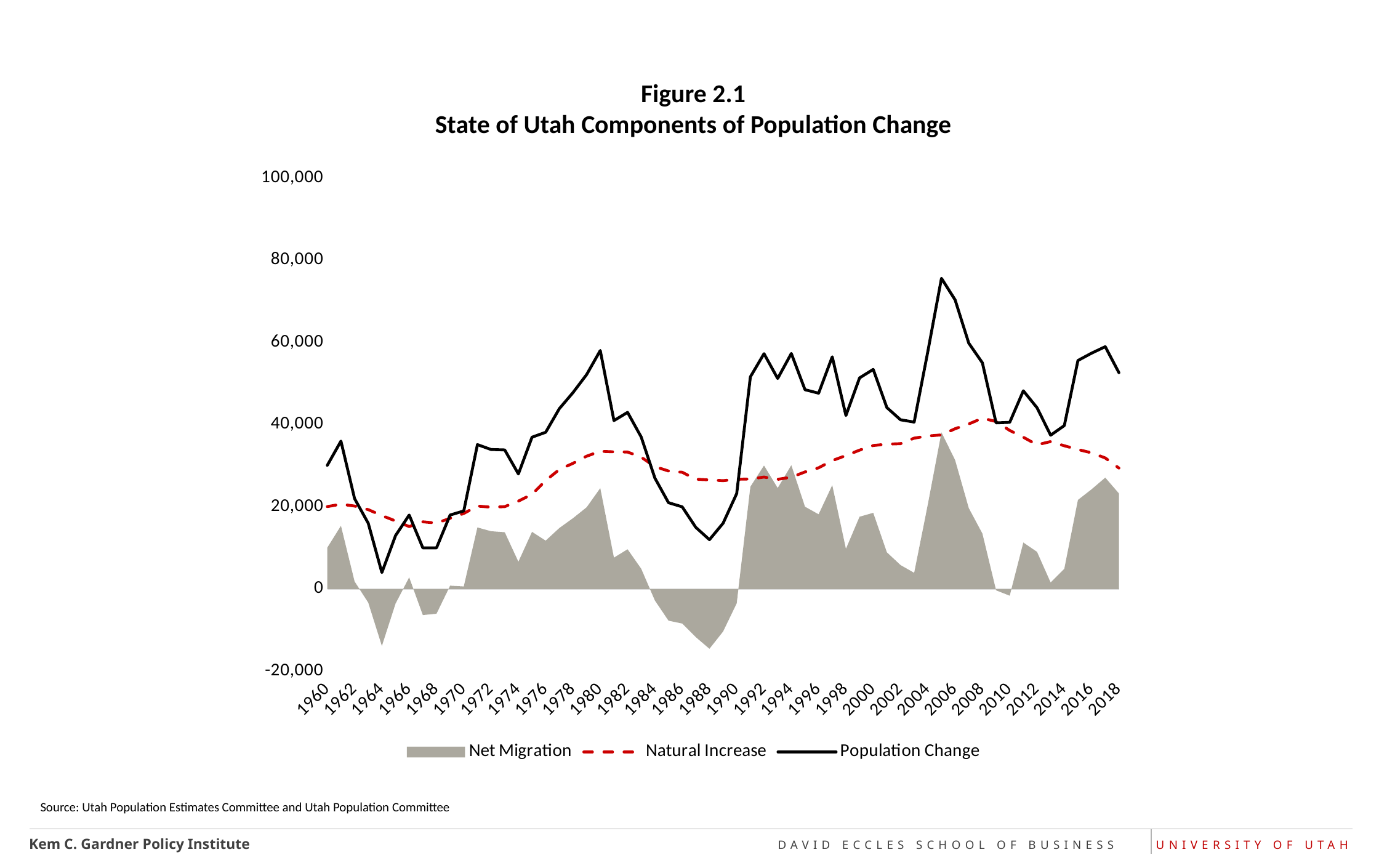
In which year does the Population Change line reach its highest value? 2005 Which series is drawn as a shaded grey area? Net Migration What is the title of the chart? Figure 2.1 State of Utah Components of Population Change Is the Net Migration value for 1988 greater or less than 0? less How many series does the legend list? 3 Is the Population Change value for 2006 greater or less than 60,000? greater In 2006, which is larger: Population Change or Natural Increase? Population Change Does the Natural Increase line rise or fall from 2008 to 2018? fall Is the Net Migration value for 2006 greater or less than 20,000? greater In 1988, which is larger: Natural Increase or Population Change? Natural Increase In which year does the Population Change line reach its lowest value? 1964